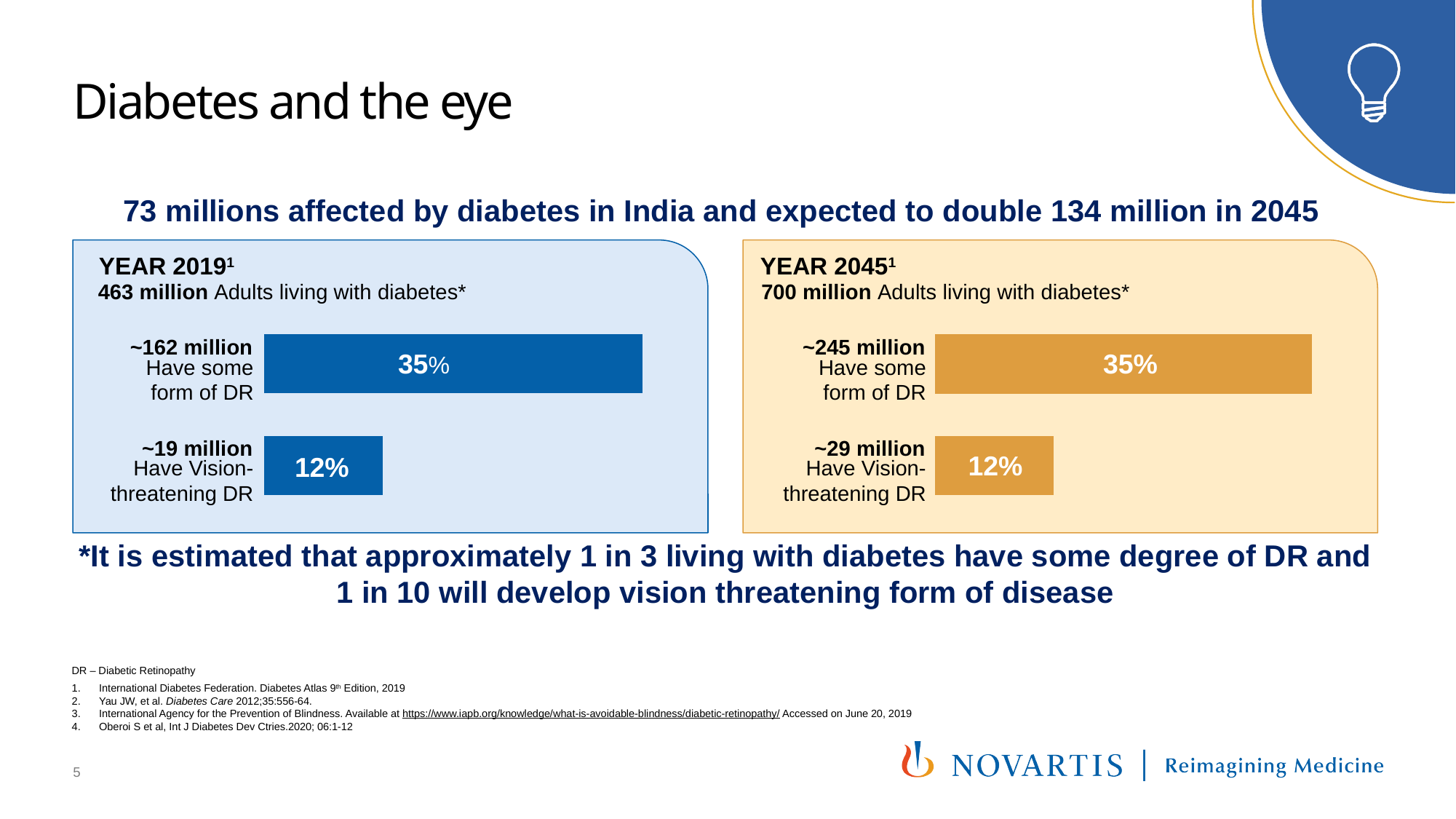
What colour are the bars in the YEAR 2045 chart? orange In the YEAR 2045 chart, what percentage have vision-threatening DR? 12% How many bars are shown in the YEAR 2019 chart? 2 In the YEAR 2019 chart, what is the difference in percentage points between the 'Have some form of DR' bar and the 'Have Vision-threatening DR' bar? 23 percentage points In the YEAR 2019 chart, what percentage have vision-threatening DR? 12% In the YEAR 2045 chart, is the percentage for 'Have some form of DR' larger or smaller than the percentage for 'Have Vision-threatening DR'? larger What type of chart is used in the YEAR 2045 panel? bar chart In the YEAR 2019 chart, which category has the larger bar? Have some form of DR In the YEAR 2045 chart, which category has the smaller bar? Have Vision-threatening DR In the YEAR 2045 chart, what percentage have some form of DR? 35% In the YEAR 2045 chart, how many million adults are estimated to have some form of DR? ~245 million In the YEAR 2019 chart, what percentage of adults living with diabetes have some form of DR? 35%